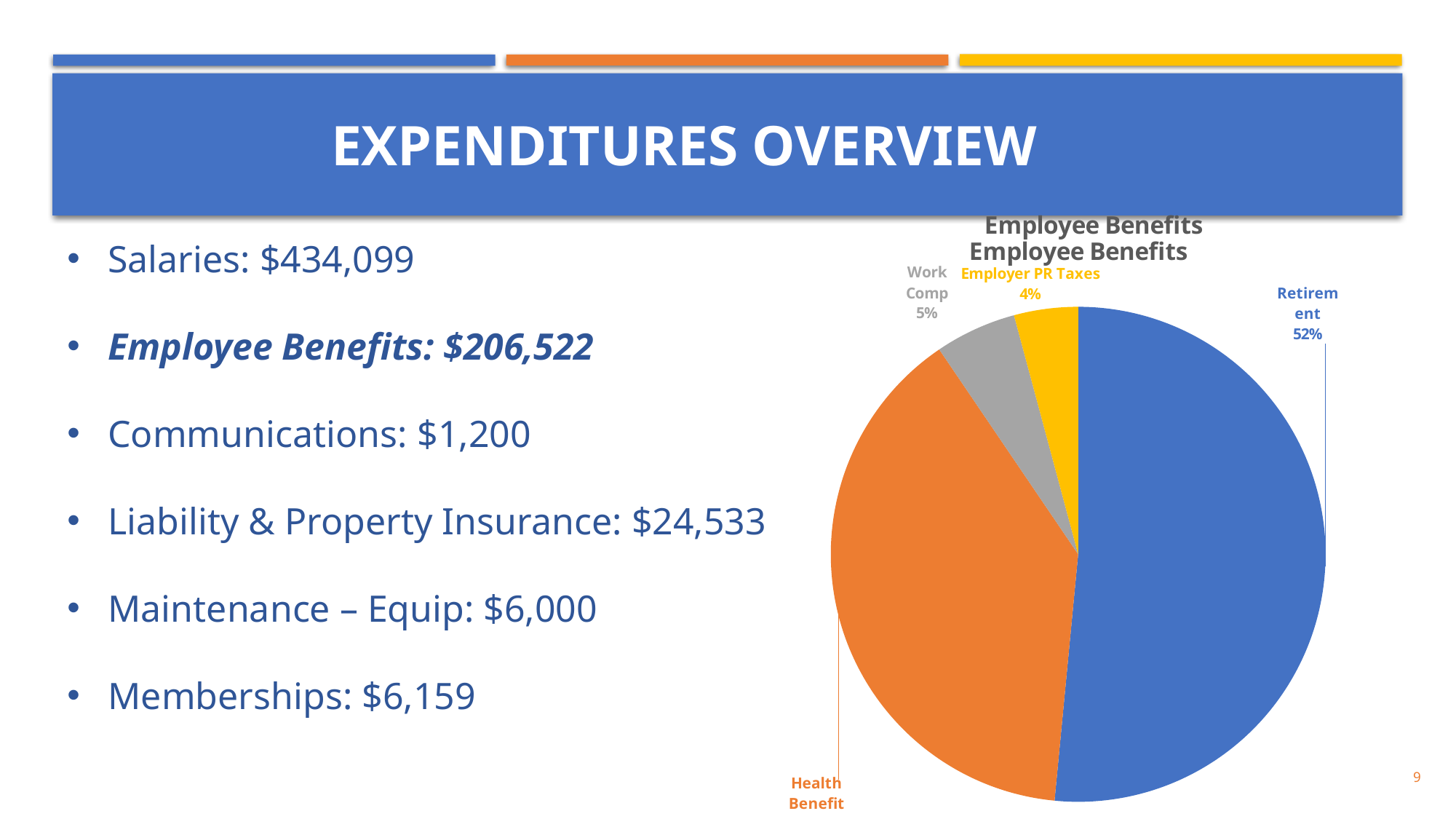
Which is larger in the pie chart, Work Comp or Employer PR Taxes? Work Comp What kind of chart is shown on the slide? pie chart What percentage of the pie chart is Work Comp? 5% How many slices does the pie chart have? 4 What is the title of the pie chart? Employee Benefits What percentage of the pie chart is Employer PR Taxes? 4% What colour is the Retirement slice in the pie chart? blue Which slice of the pie chart is the largest? Retirement Which is larger in the pie chart, Retirement or Health Benefit? Retirement Which slice of the pie chart is the smallest? Employer PR Taxes What is the difference in percentage points between the Retirement slice and the Work Comp slice? 47 What percentage of the pie chart is Retirement? 52%